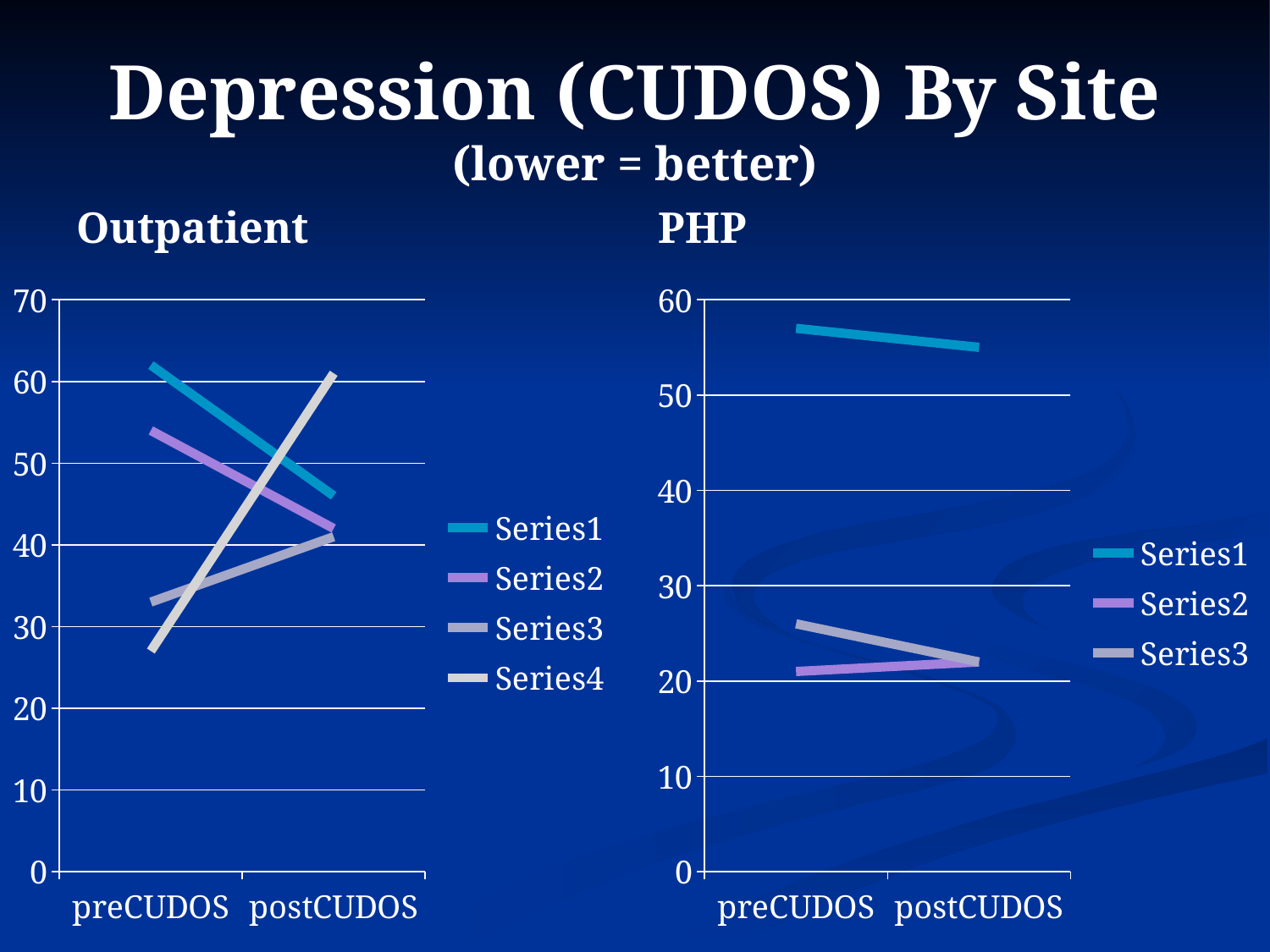
In the PHP chart, is the preCUDOS value for Series1 greater or less than 50? greater In the PHP chart, does Series3 rise or fall from preCUDOS to postCUDOS? fall How many series does the legend of the PHP chart list? 3 In the Outpatient chart, does Series4 rise or fall from preCUDOS to postCUDOS? rise In the Outpatient chart, is the preCUDOS value for Series4 greater or less than 30? less In the Outpatient chart, is the postCUDOS value for Series4 greater or less than 50? greater What is the subtitle shown under the slide title? (lower = better) How many series does the legend of the Outpatient chart list? 4 In the PHP chart, which is larger at preCUDOS, Series1 or Series3? Series1 How many categories are on the x axis of the PHP chart? 2 In the Outpatient chart, does Series1 rise or fall from preCUDOS to postCUDOS? fall What kind of chart is the Outpatient chart? line chart